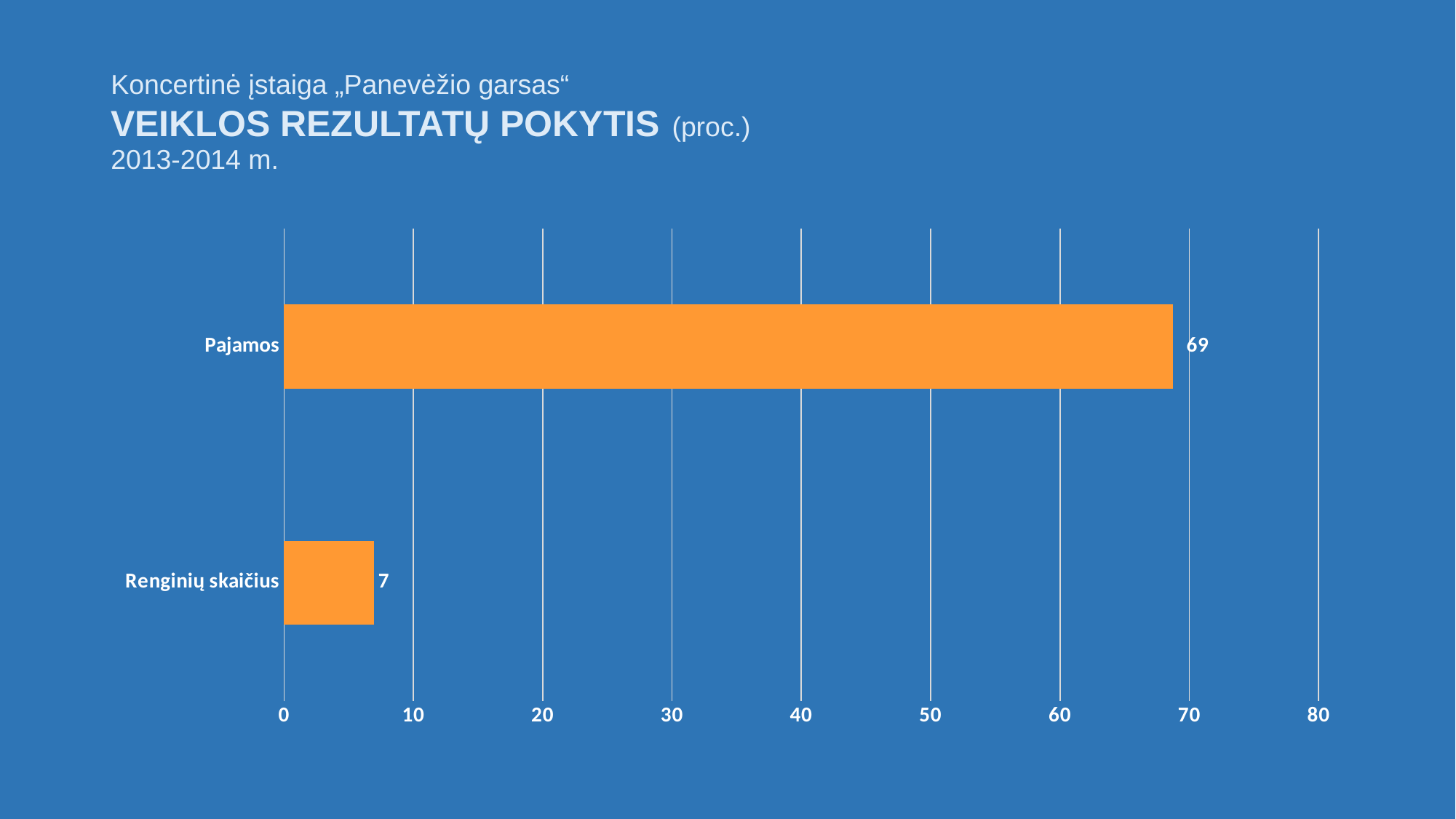
How many categories are shown in the chart? 2 Is the value for Renginių skaičius greater or less than 10? less What is the value for Renginių skaičius? 7 What kind of chart is shown on the slide? bar chart What colour are the bars in the chart? orange Which category has the lowest value? Renginių skaičius What is the difference between the values for Pajamos and Renginių skaičius? 62 What is the value for Pajamos? 69 What is the highest value shown on the x axis? 80 Which category has the highest value? Pajamos Is the value for Pajamos greater or less than 60? greater Which is larger, the value for Pajamos or the value for Renginių skaičius? Pajamos